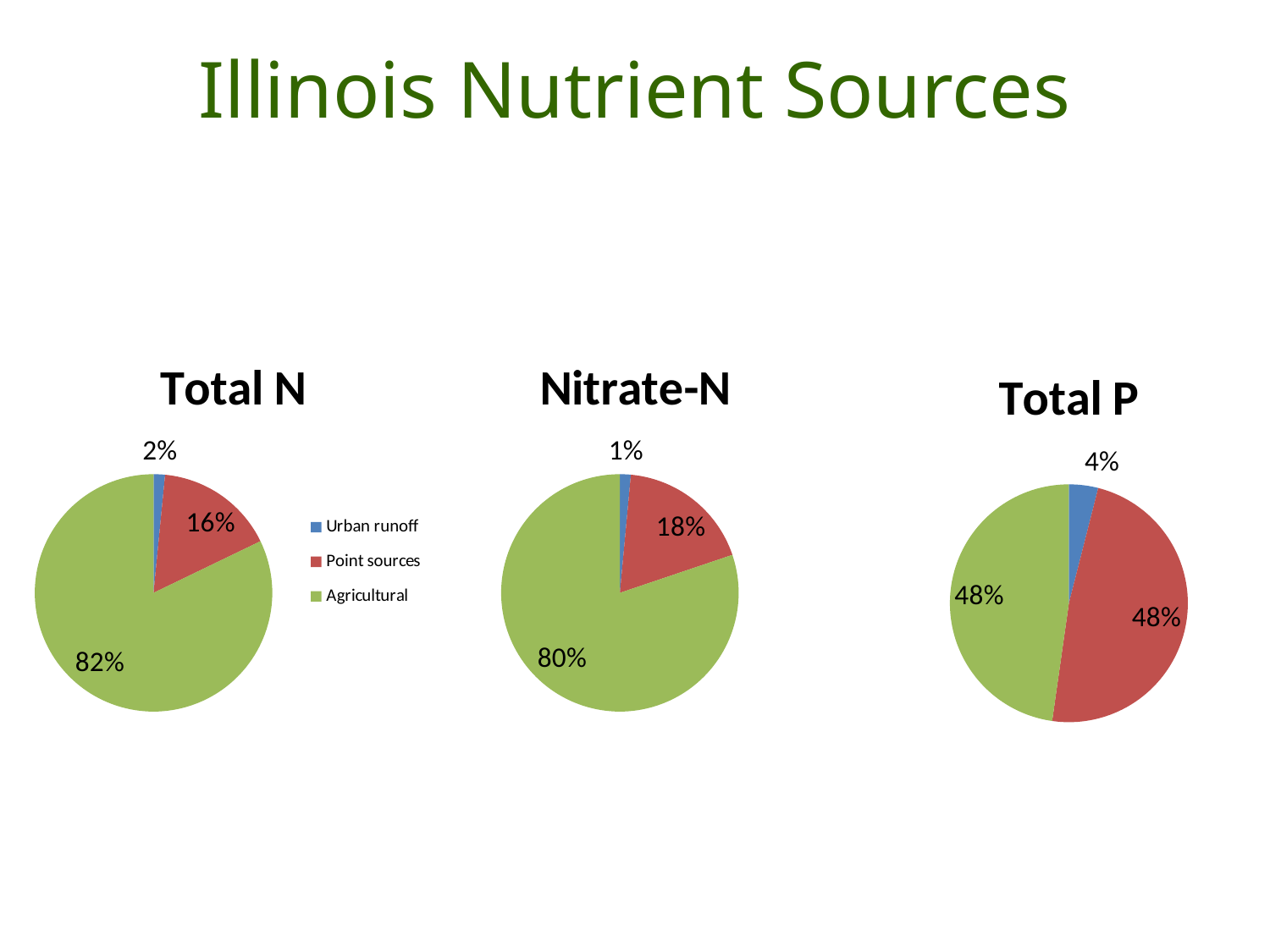
In the Nitrate-N chart, which is larger, Point sources or Urban runoff? Point sources How many pie charts are on the slide? 3 In the Total N chart, which category has the largest slice? Agricultural In the Total N chart, what share does Agricultural have? 82% How many categories does the legend list? 3 In the Total N chart, what share does Point sources have? 16% In the Nitrate-N chart, which category has the smallest slice? Urban runoff What kind of chart is the Total P chart? Pie chart In the Nitrate-N chart, what share does Agricultural have? 80% In the Total N chart, what is the difference between the Agricultural share and the Point sources share? 66%